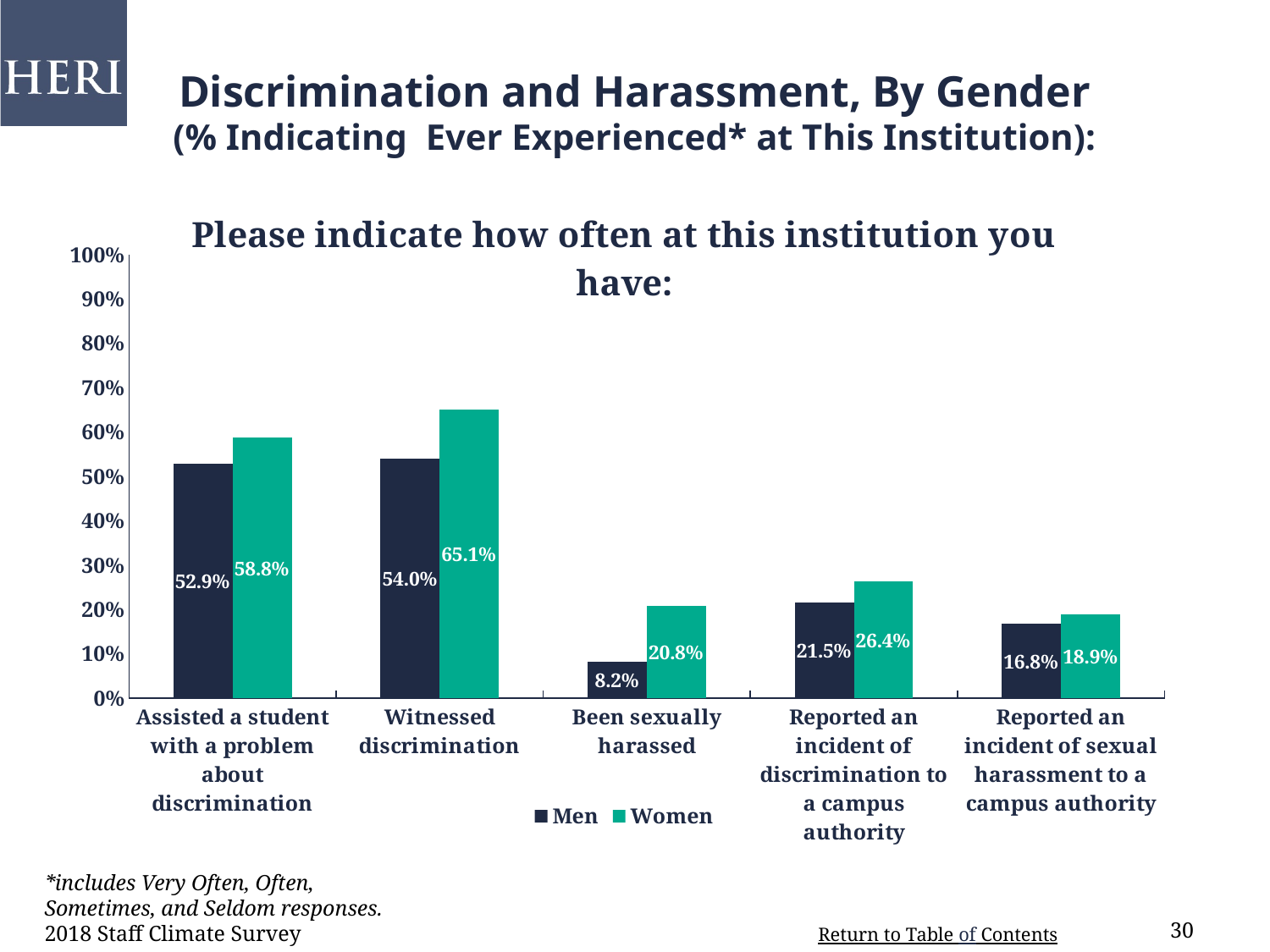
How many categories are shown on the x axis? 5 What kind of chart is shown on the slide? Bar chart How many series does the legend list? 2 Is the value for women for 'Witnessed discrimination' greater or less than 60%? greater What percentage of men indicated they had been sexually harassed? 8.2% Which category has the highest value for women? Witnessed discrimination What percentage of women indicated they had witnessed discrimination? 65.1% What is the difference between women and men for 'Been sexually harassed'? 12.6% Which category has the lowest value for men? Been sexually harassed What is the value for men for 'Reported an incident of sexual harassment to a campus authority'? 16.8% What is the difference between women and men for 'Assisted a student with a problem about discrimination'? 5.9% For 'Reported an incident of discrimination to a campus authority', which group has the larger value, men or women? Women